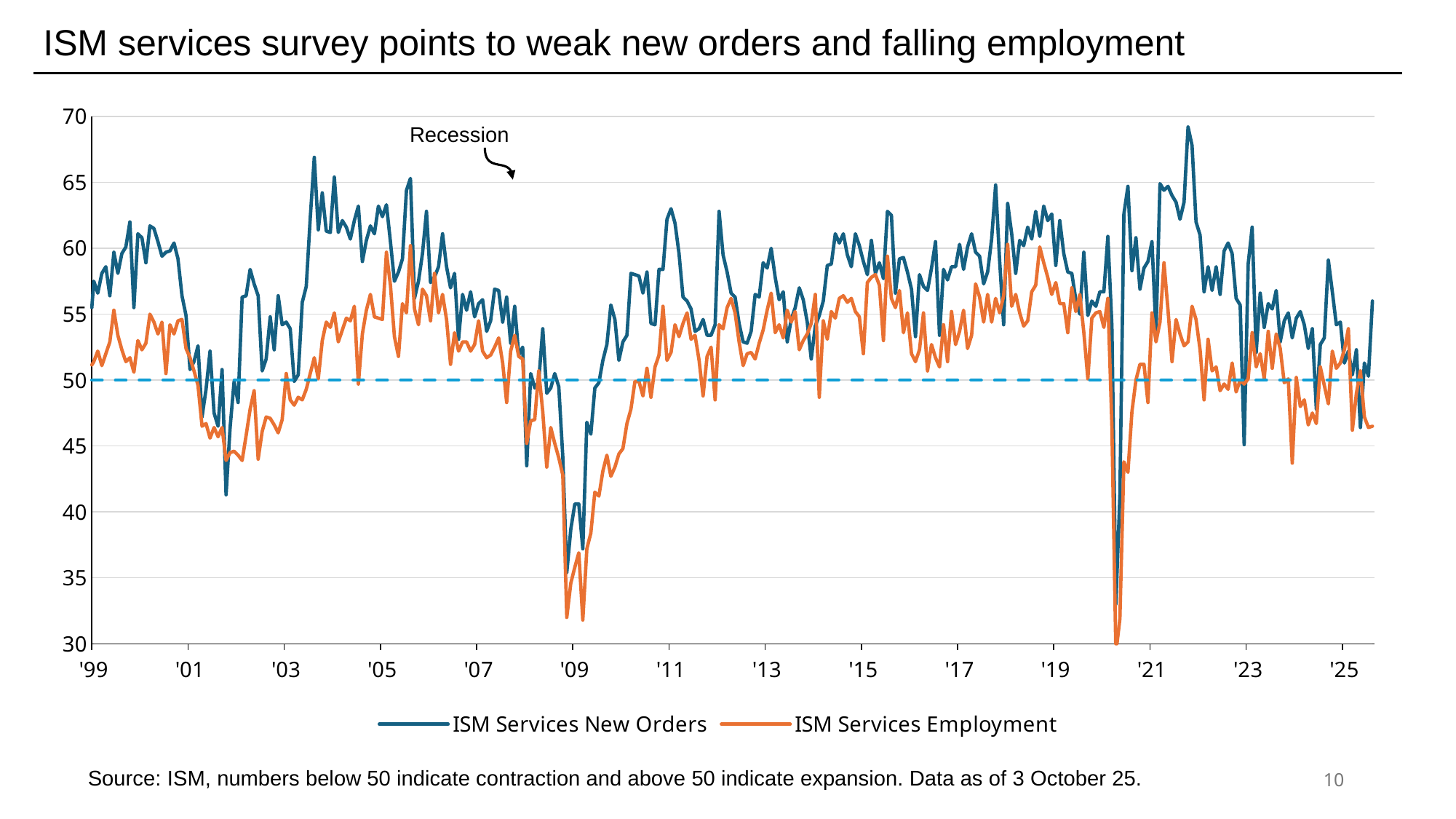
At what level is the horizontal dashed line drawn on the chart? 50 Is the lowest value of ISM Services Employment (around 2020) greater or less than 35? less What does the annotation with the arrow near 2007 on the chart say? Recession Is the lowest value of ISM Services New Orders around 2009 greater or less than 40? less At the end of the series in 2025, which is higher: ISM Services New Orders or ISM Services Employment? ISM Services New Orders What kind of chart is shown on the slide? line chart Is the highest value of ISM Services New Orders (around 2021) greater or less than 65? greater Between its peak in 2021 and 2025, did ISM Services New Orders generally rise or fall? fall How many series does the legend list? 2